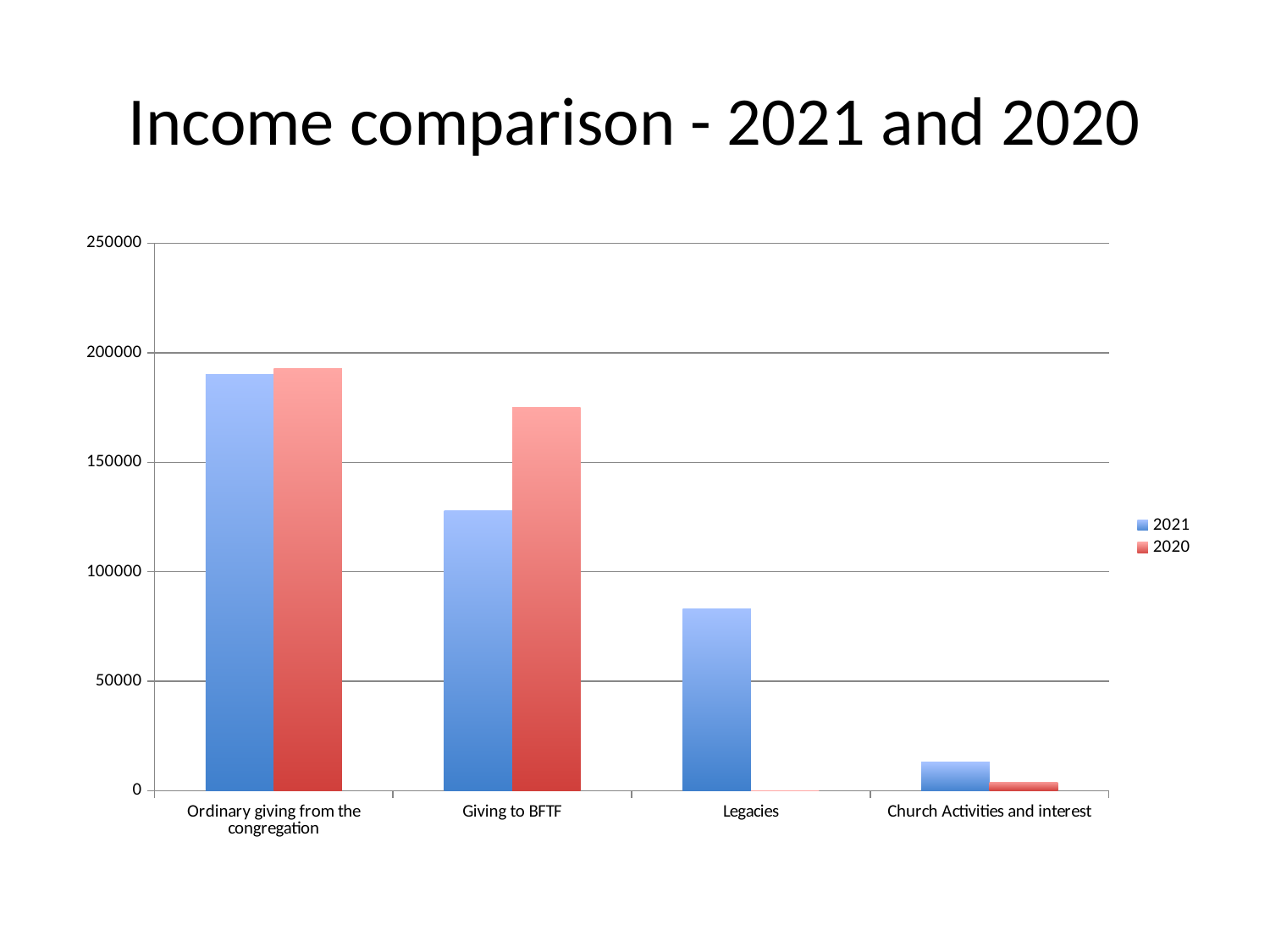
Which category has the highest 2021 value? Ordinary giving from the congregation For Giving to BFTF, which year has the larger value, 2021 or 2020? 2020 Is the 2021 value for Ordinary giving from the congregation greater or less than 150000? greater How many series does the legend list? 2 What kind of chart is shown on the slide? bar chart For Legacies, which year has the larger value, 2021 or 2020? 2021 What is the title of the chart? Income comparison - 2021 and 2020 Is the 2020 value for Giving to BFTF greater or less than 150000? greater Is the 2021 value for Legacies greater or less than 100000? less How many categories are shown on the x axis? 4 Which category has the lowest 2020 value? Legacies